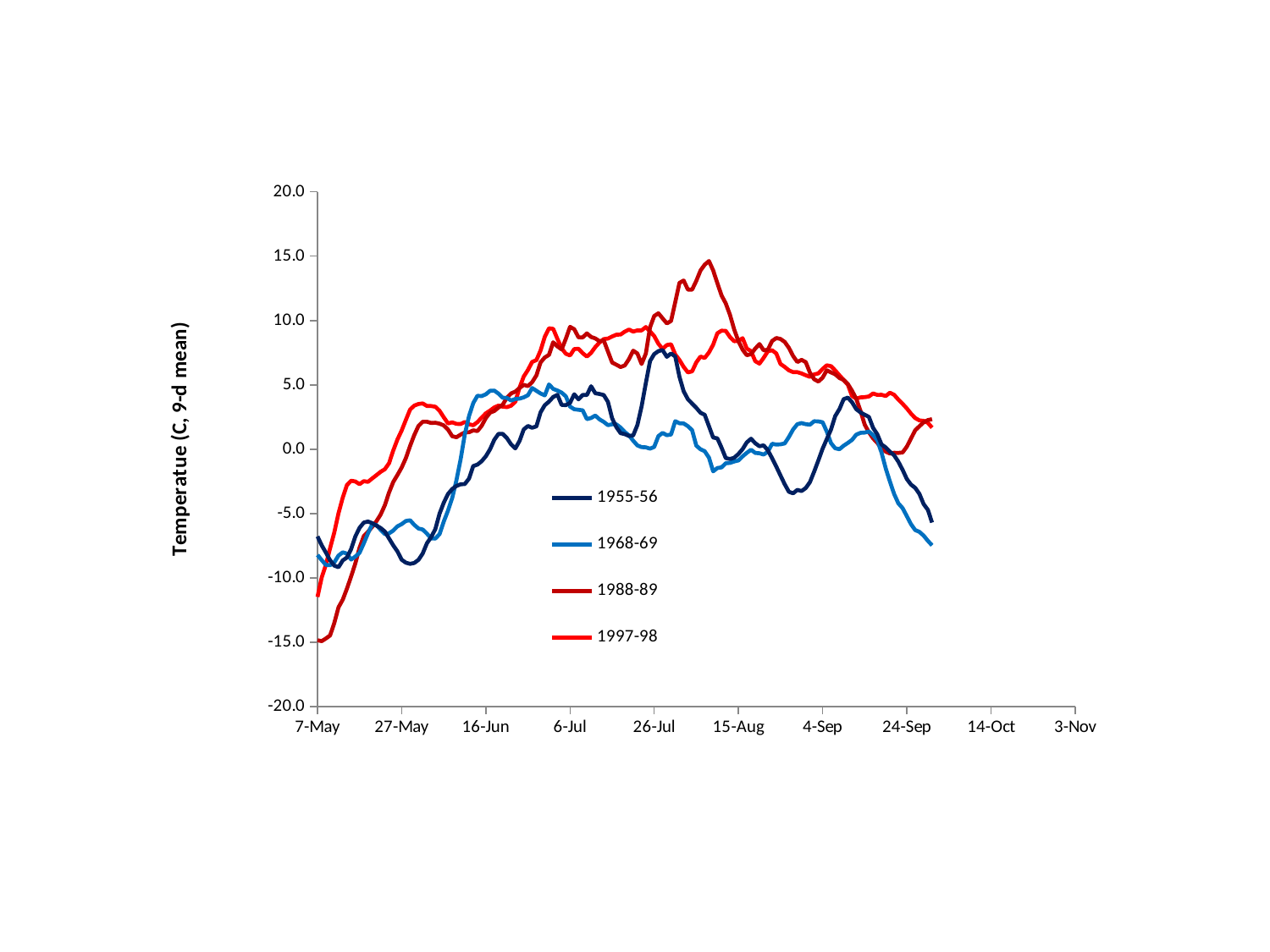
Is the value for 1968-69 at 16-Jun greater or less than 0.0? greater What is the label on the vertical axis? Temperatue (C, 9-d mean) Between 7-May and 6-Jul, do the values of the 1988-89 series rise or fall? rise Which series has the lowest value at 7-May? 1988-89 Is the peak value of the 1988-89 series greater or less than 10.0? greater Which series are listed in the legend? 1955-56, 1968-69, 1988-89, 1997-98 Is the value for 1955-56 at 7-May greater or less than -5.0? less What kind of chart is shown on the slide? line chart At 26-Jul, which series has the higher value, 1988-89 or 1968-69? 1988-89 How many series does the legend list? 4 Which series reaches the highest temperature on the chart? 1988-89